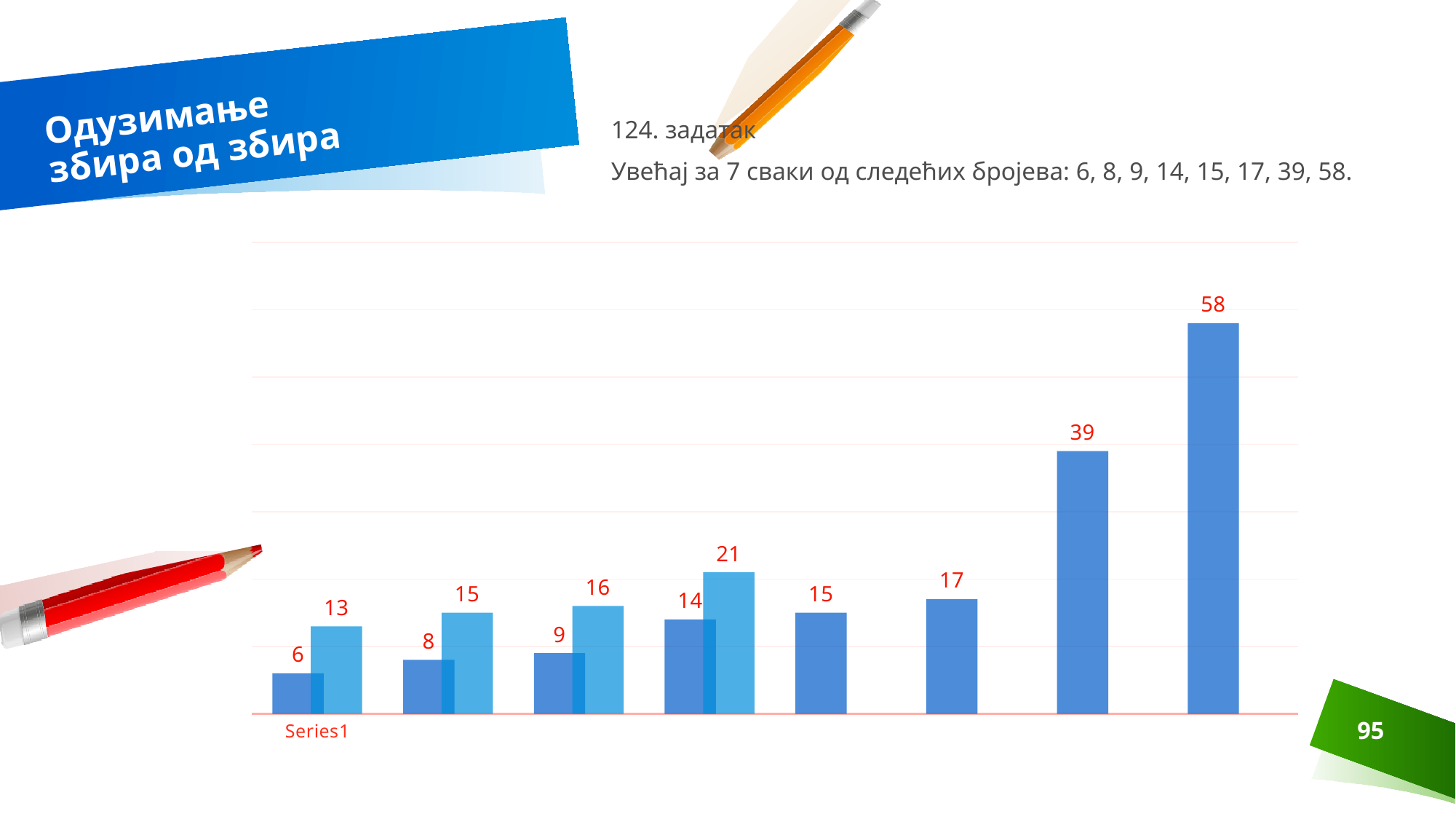
Do the values of the dark blue bars rise or fall from left to right? rise What is the value of the light blue bar in the fourth group from the left? 21 What is the lowest value labeled on the chart? 6 What is the value of the rightmost bar on the chart? 58 What is the highest value labeled on the chart? 58 How many dark blue bars are plotted on the chart? 8 What category label is printed under the first group of bars? Series1 How many light blue bars are plotted on the chart? 4 Which is larger, the bar labeled 39 or the bar labeled 17? 39 What is the difference between the light blue bar (13) and the dark blue bar (6) in the first group? 7 What kind of chart is shown on the slide? bar chart What is the difference between the two tallest dark blue bars (58 and 39)? 19